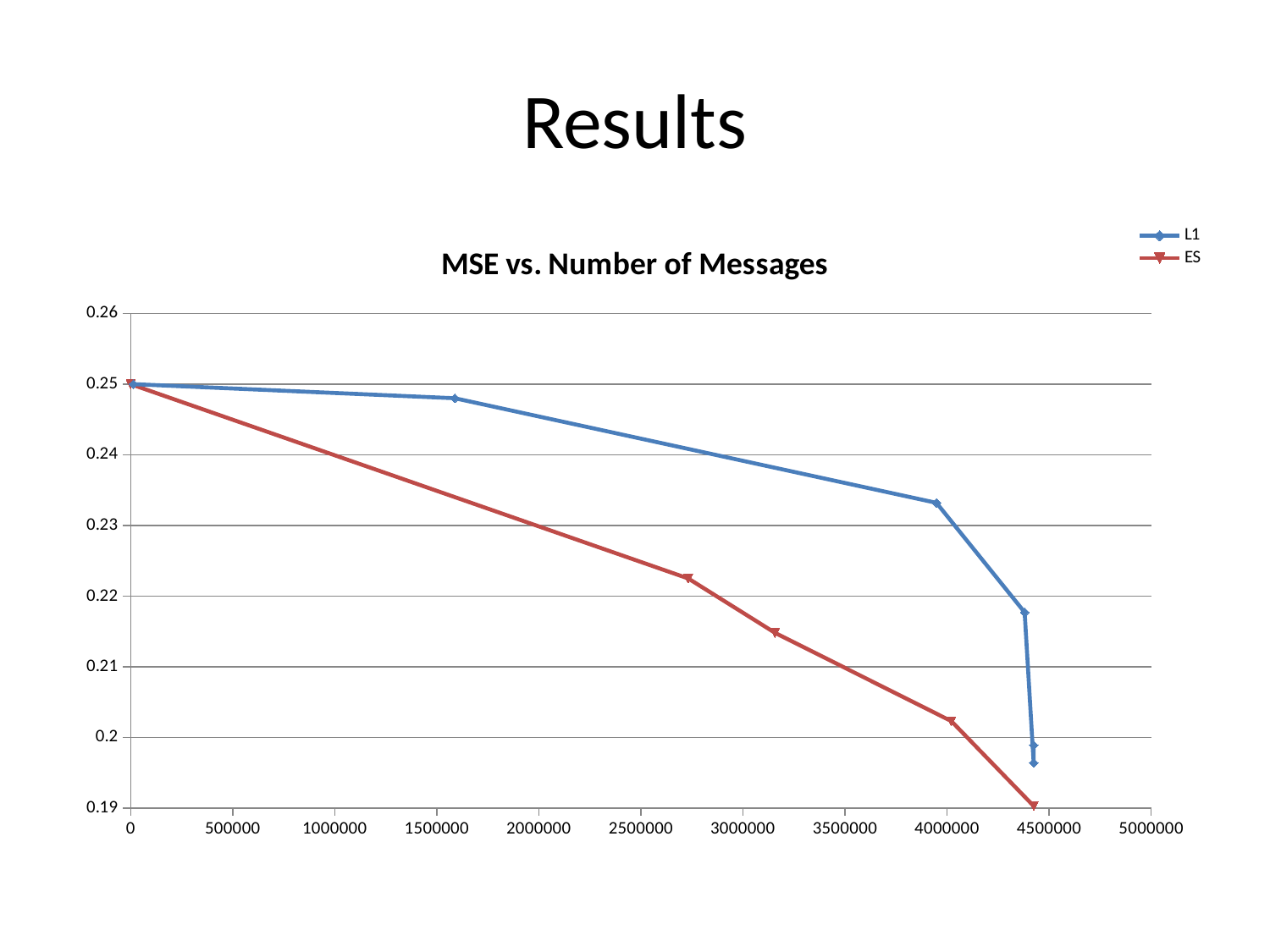
Do the MSE values of the ES series rise or fall as the number of messages increases? fall Do the MSE values of the L1 series rise or fall as the number of messages increases? fall Is the MSE value of the L1 series at about 3950000 messages greater or less than 0.23? greater What is the MSE value of the ES series at 0 messages? 0.25 What is the title of the chart? MSE vs. Number of Messages Which series is drawn in red? ES Is the MSE value of the ES series at about 3150000 messages greater or less than 0.22? less What is the MSE value of the L1 series at 0 messages? 0.25 What kind of chart is shown on the slide? line chart How many series does the legend list? 2 At around 4000000 messages, which series has the higher MSE, L1 or ES? L1 Is the MSE value of the L1 series at about 1600000 messages greater or less than 0.24? greater